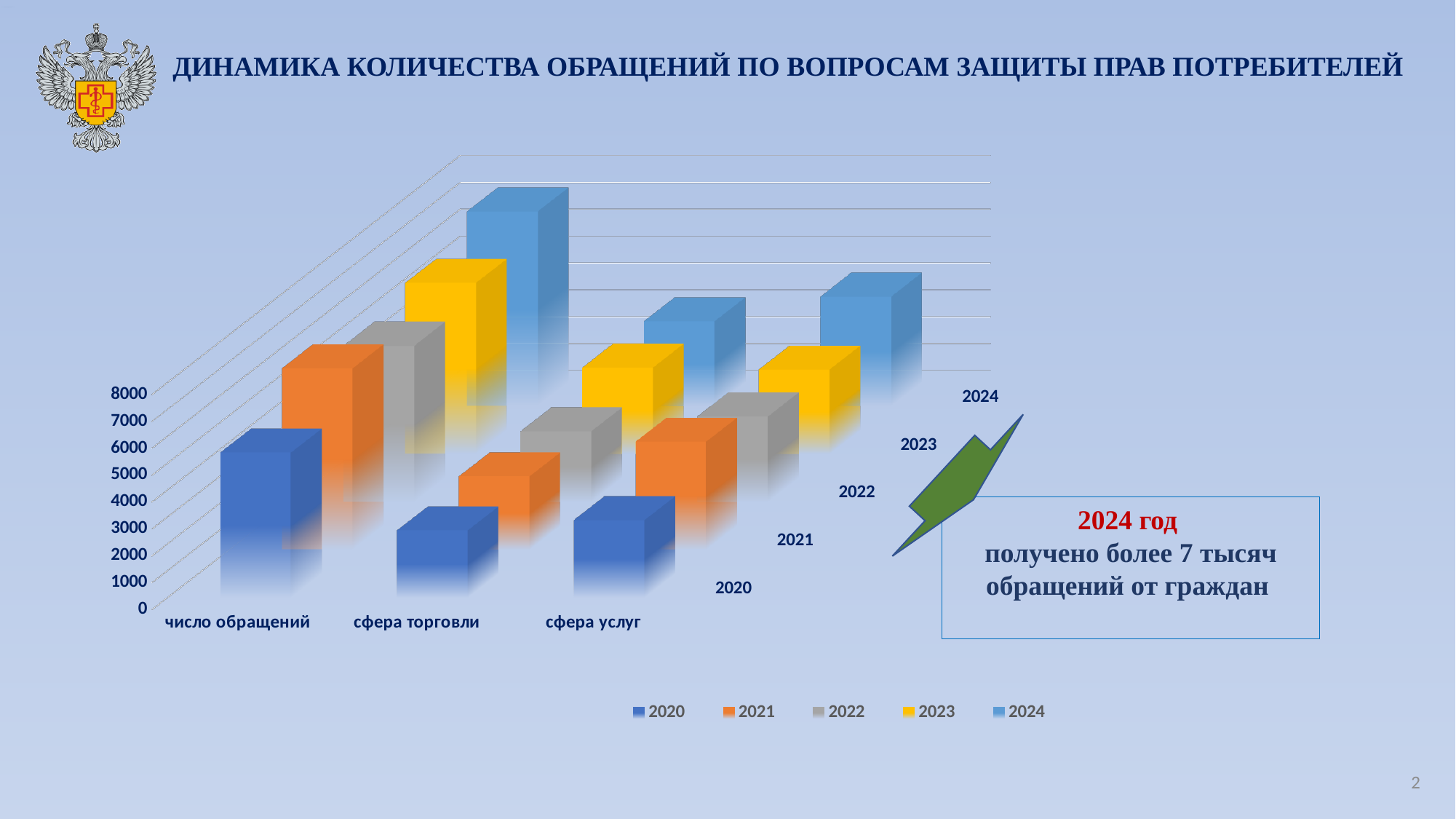
Which years are listed in the chart legend? 2020, 2021, 2022, 2023, 2024 For 2020, which is larger: 'число обращений' or 'сфера торговли'? число обращений What is the highest tick value shown on the vertical axis of the chart? 8000 What is the title of the slide containing the chart? ДИНАМИКА КОЛИЧЕСТВА ОБРАЩЕНИЙ ПО ВОПРОСАМ ЗАЩИТЫ ПРАВ ПОТРЕБИТЕЛЕЙ How many categories are shown on the x axis of the chart? 3 For the category 'число обращений', which year has the highest value? 2024 How many series does the chart legend list? 5 For the 2020 series, which category has the highest value? число обращений What kind of chart is shown on the slide? bar chart Is the 2020 value for 'сфера услуг' greater or less than 5000? less Is the 2020 value for 'сфера торговли' greater or less than 4000? less Is the 2020 value for 'число обращений' greater or less than 4000? greater